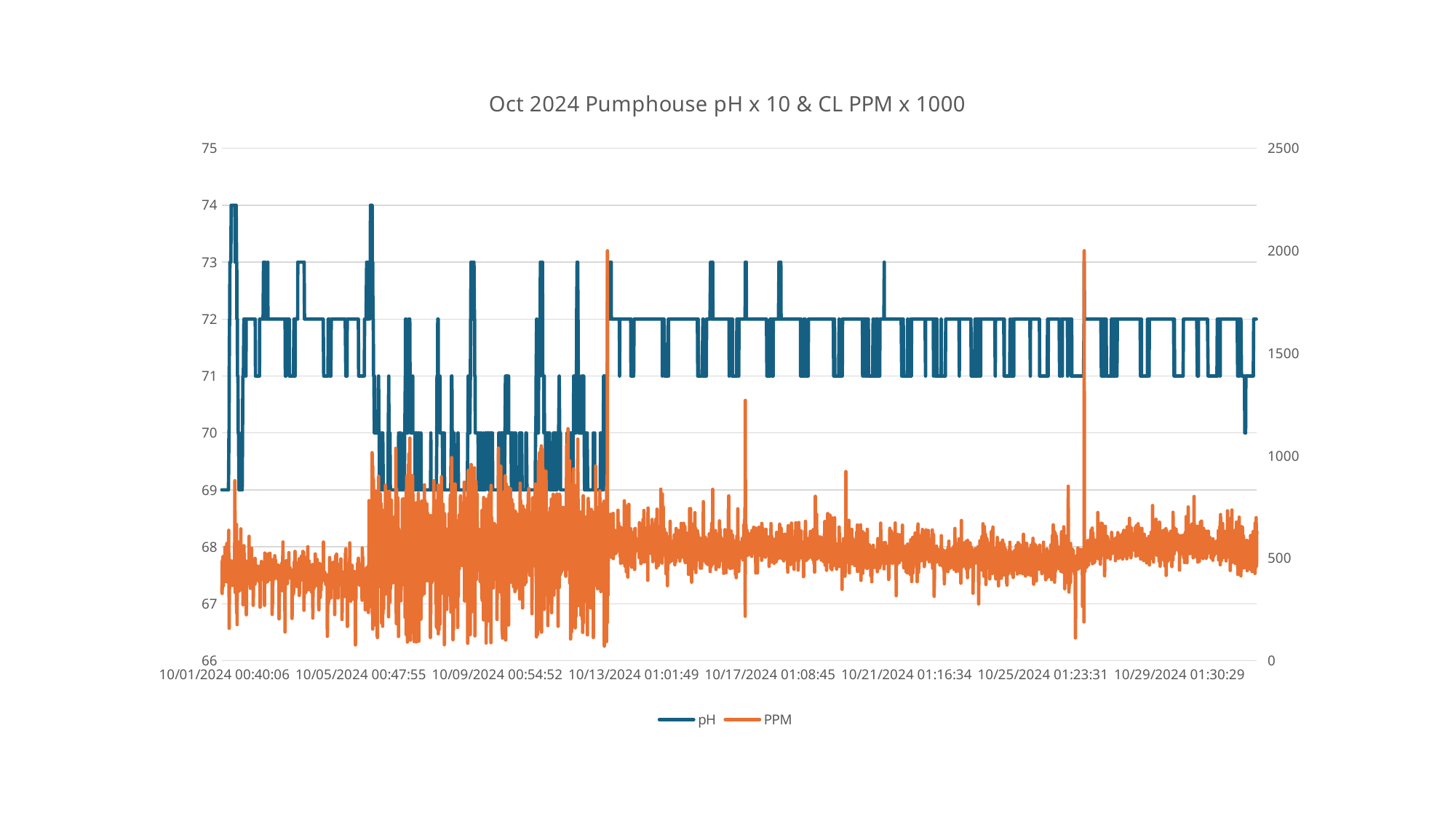
What is the highest value reached by the pH series? 74 Which series is drawn in orange? PPM What is the maximum value shown on the left-hand axis? 75 What is the lowest value reached by the pH series? 69 Is the PPM value at the start of the month (10/01/2024) greater or less than 1000? less How many series does the legend list? 2 How many date labels are shown along the x axis? 8 What is the maximum value shown on the right-hand axis? 2500 Is the PPM spike near 10/17/2024 greater or less than 1000? greater What type of chart is shown on the slide? line chart Is the PPM spike near 10/25/2024 greater or less than 1500? greater What is the title of the chart? Oct 2024 Pumphouse pH x 10 & CL PPM x 1000